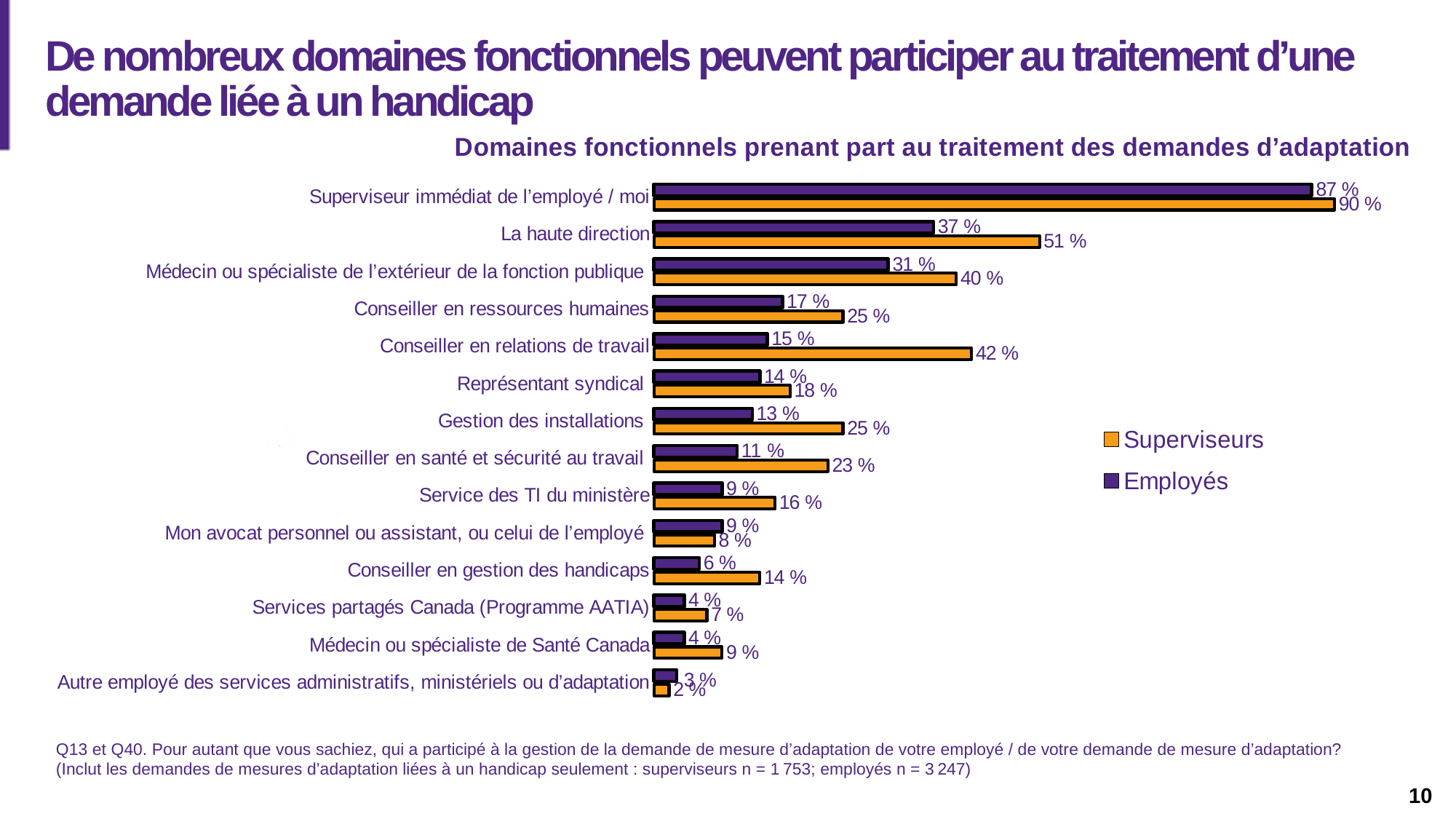
What is the title of the chart? Domaines fonctionnels prenant part au traitement des demandes d’adaptation What is the Superviseurs value for "Conseiller en gestion des handicaps"? 14 % Which category has the highest Employés value? Superviseur immédiat de l’employé / moi What is the difference between the Superviseurs and Employés values for "Conseiller en relations de travail"? 27 % What kind of chart is shown on the slide? Bar chart For "Mon avocat personnel ou assistant, ou celui de l’employé", which series has the larger value, Superviseurs or Employés? Employés Which colour represents the Superviseurs series? Orange How many series does the legend list? 2 Which category has the lowest Superviseurs value? Autre employé des services administratifs, ministériels ou d’adaptation How many categories are shown in the chart? 14 What is the Superviseurs value for "La haute direction"? 51 % What is the Employés value for "Conseiller en relations de travail"? 15 %